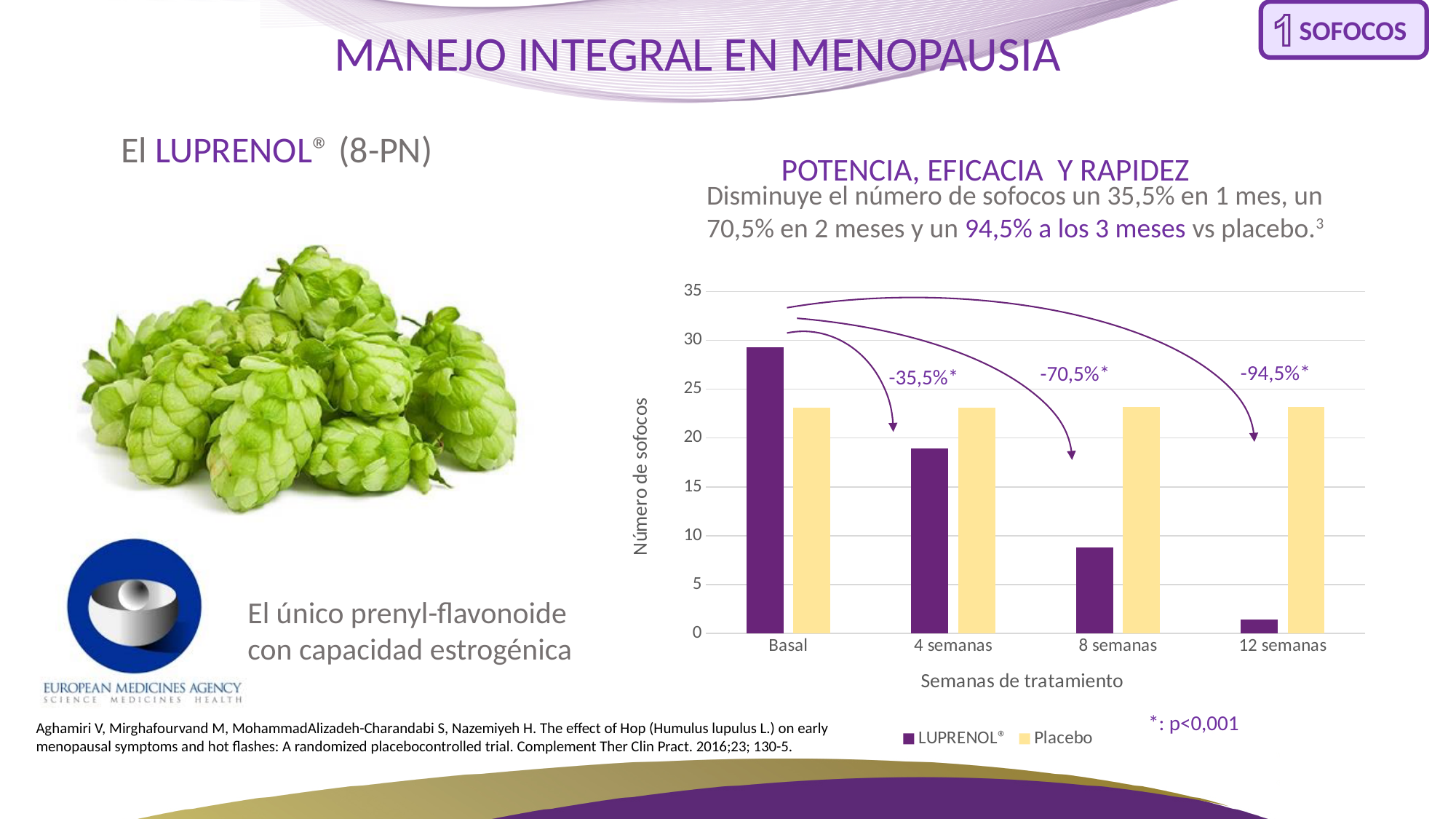
Is the Placebo value at 4 semanas greater or less than 20? greater Is the LUPRENOL value at 8 semanas greater or less than 10? less At 12 semanas, which series has the larger value, LUPRENOL or Placebo? Placebo How many series does the chart legend list? 2 What is the title of the vertical axis of the chart? Número de sofocos At which category is the LUPRENOL value lowest? 12 semanas What kind of chart is shown on the slide? bar chart How many categories are shown on the x axis of the chart? 4 Do the LUPRENOL values rise or fall from Basal to 12 semanas? fall Is the LUPRENOL value at Basal greater or less than 25? greater At which category is the LUPRENOL value highest? Basal Which series does the legend list besides LUPRENOL? Placebo